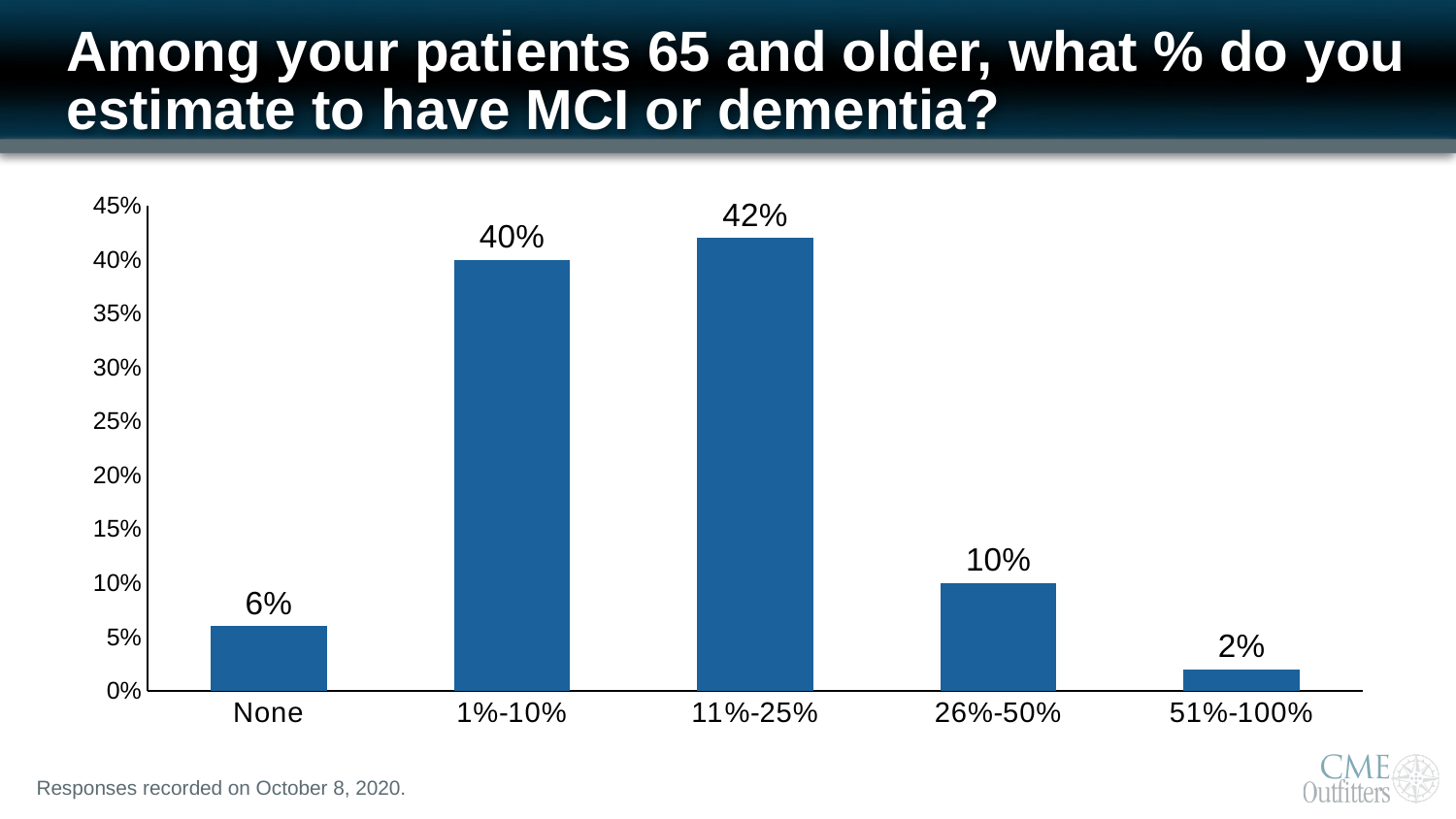
What is the highest value shown on the y axis? 45% What is the value for the "11%-25%" category? 42% Is the value for "1%-10%" greater or less than 35%? greater What is the value for the "26%-50%" category? 10% What is the value for the "None" category? 6% Which is larger, the value for "None" or the value for "26%-50%"? 26%-50% What is the difference between the values for "1%-10%" and "26%-50%"? 30% Which category has the lowest value? 51%-100% What kind of chart is shown on the slide? bar chart Which category has the highest value? 11%-25% What is the difference between the values for "11%-25%" and "1%-10%"? 2% How many categories are shown on the x axis? 5